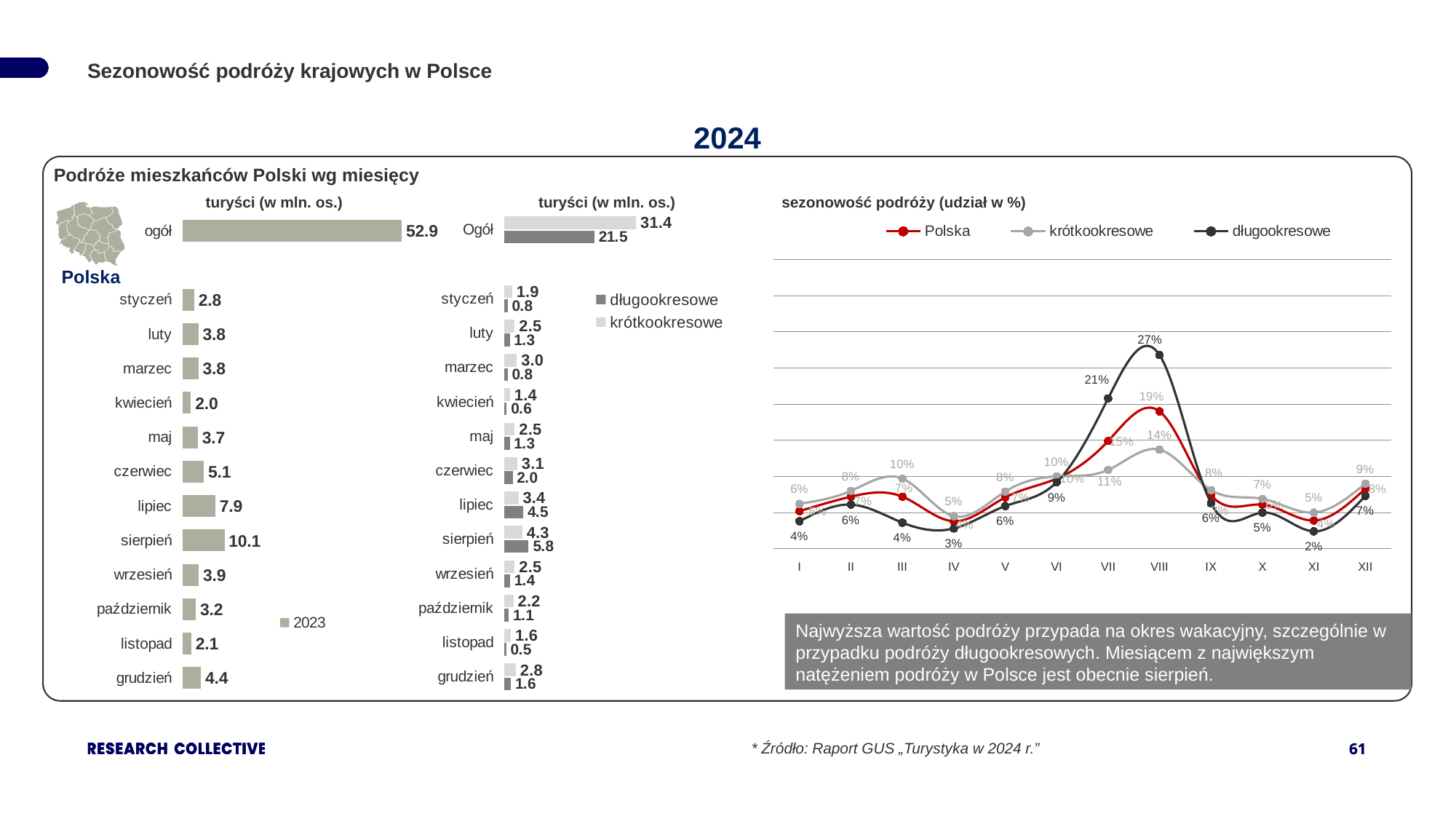
In the middle bar chart (turyści w mln. os., długookresowe/krótkookresowe), what is the krótkookresowe value for Ogół? 31.4 In the left bar chart (turyści w mln. os.), what is the difference between the values for sierpień and lipiec? 2.2 In the left bar chart (turyści w mln. os.), what is the value for sierpień? 10.1 In the right chart (sezonowość podróży, udział w %), in which month does the długookresowe series reach its highest value? VIII In the left bar chart (turyści w mln. os.), which month has the lowest value? kwiecień In the middle bar chart (turyści w mln. os., długookresowe/krótkookresowe), which is larger for lipiec: długookresowe or krótkookresowe? długookresowe What kind of chart is the right chart (sezonowość podróży, udział w %)? line chart In the left bar chart (turyści w mln. os.), which month has the highest value? sierpień In the middle bar chart (turyści w mln. os., długookresowe/krótkookresowe), what is the długookresowe value for sierpień? 5.8 How many series does the legend of the right chart (sezonowość podróży, udział w %) list? 3 In the right chart (sezonowość podróży, udział w %), what is the długookresowe value for month VIII? 27% In the left bar chart (turyści w mln. os.), what is the value for ogół? 52.9